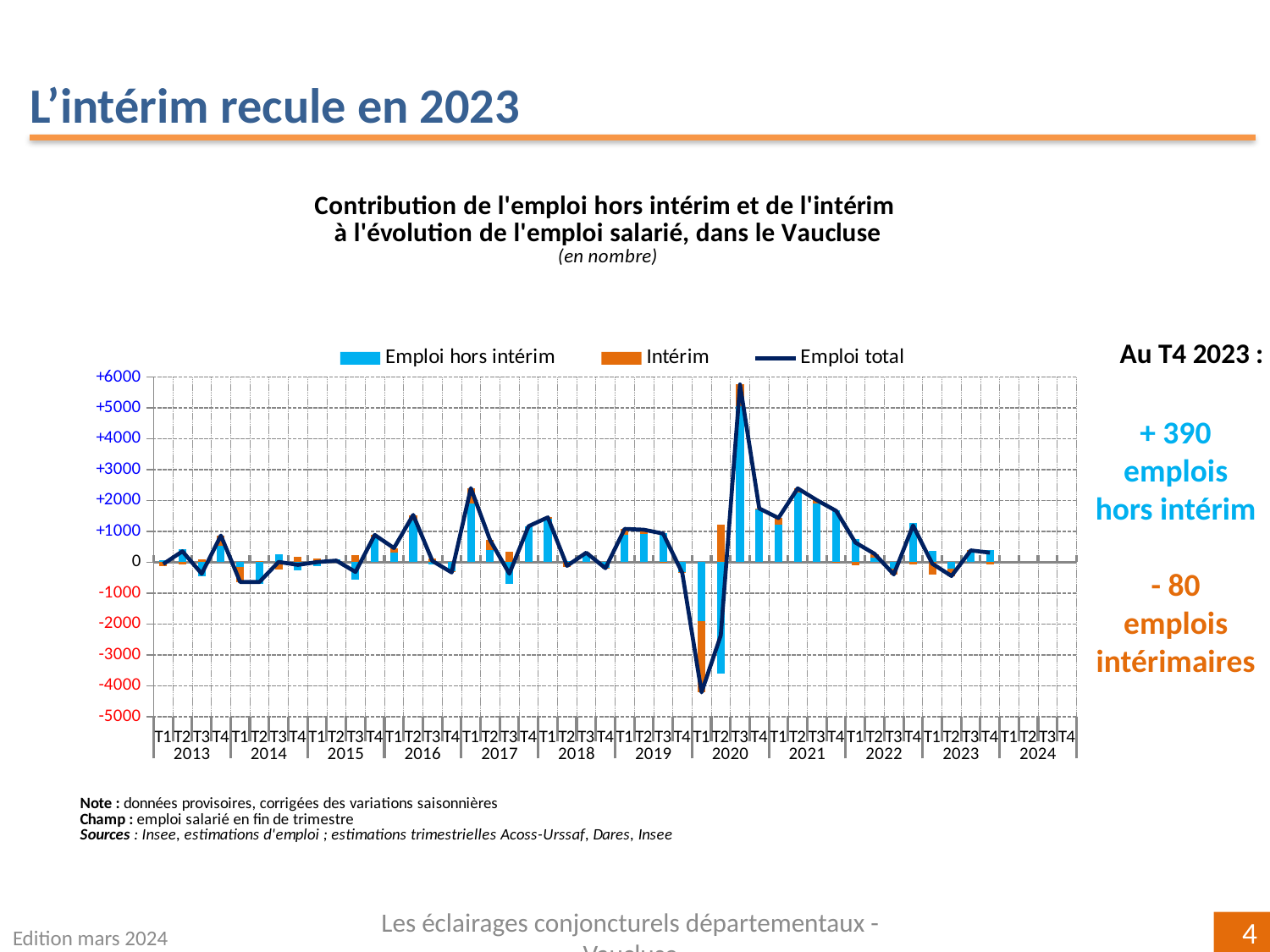
How many years are labelled along the x axis? 12 What colour are the Intérim bars? Orange What kind of chart is shown on the slide? A combined bar and line chart Which series is drawn as a line rather than bars? Emploi total According to the slide, what is the value for Intérim at T4 2023? - 80 Which is larger: the Emploi total value at T3 2020 or at T1 2017? T3 2020 According to the slide, what is the value for Emploi hors intérim at T4 2023? + 390 Is the value of Emploi total at T3 2020 greater or less than +5000? greater In which quarter does the Emploi total line reach its lowest value? T1 2020 How many series does the chart legend list? 3 Is the value of Emploi total at T1 2020 greater or less than -3000? less In which quarter does the Emploi total line reach its highest value? T3 2020